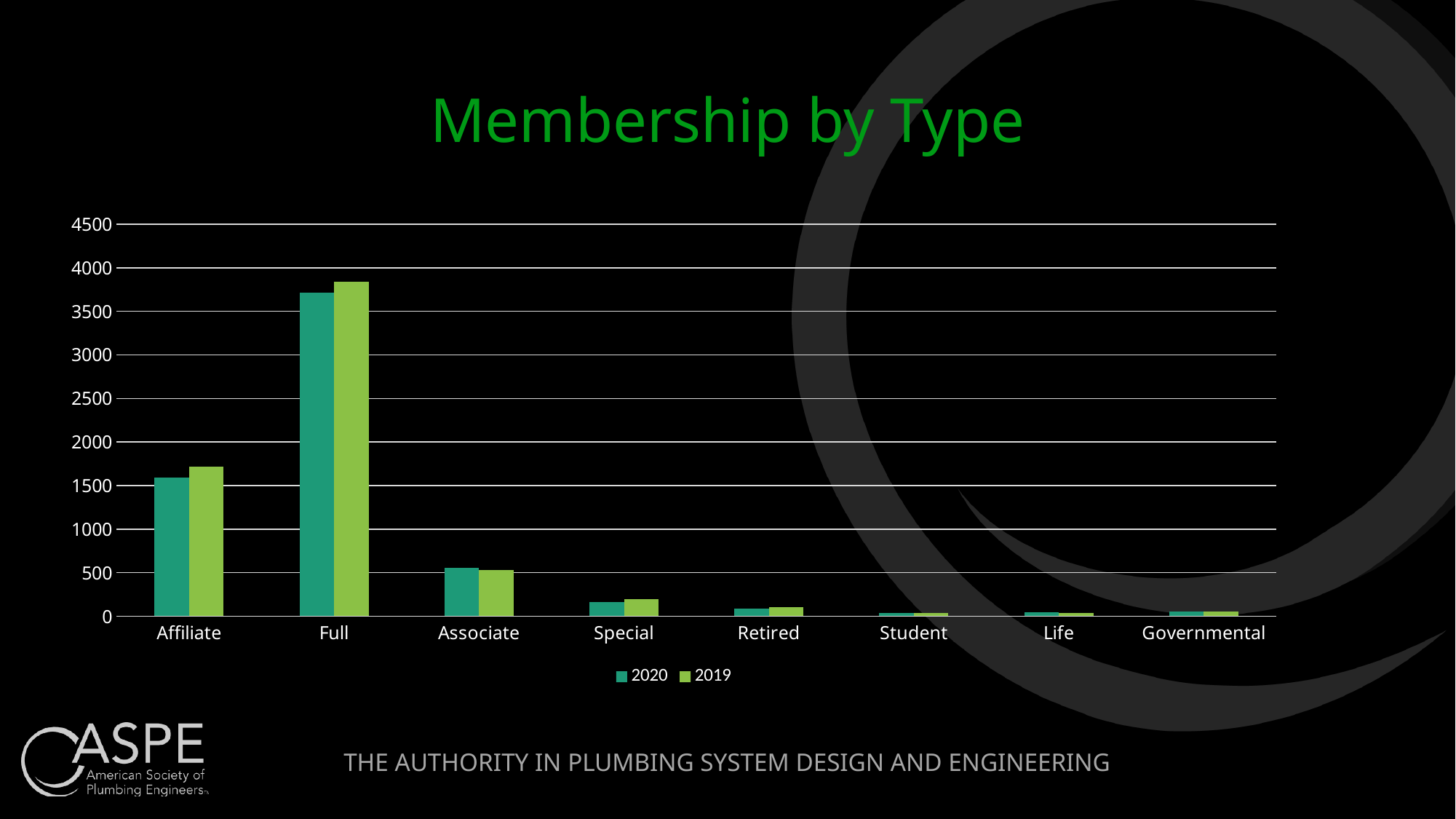
Is the 2019 value for Affiliate greater or less than 1500? greater Which membership type has the highest value for 2020? Full How many membership types are shown on the x axis? 8 What is the title of the chart? Membership by Type For Affiliate, which year has the larger value, 2020 or 2019? 2019 What type of chart is shown on the slide? Bar chart How many series does the legend list? 2 Is the 2020 value for Affiliate greater or less than 2000? less Which membership type has the highest value for 2019? Full Is the 2019 value for Special greater or less than 500? less For Full, which year has the larger value, 2020 or 2019? 2019